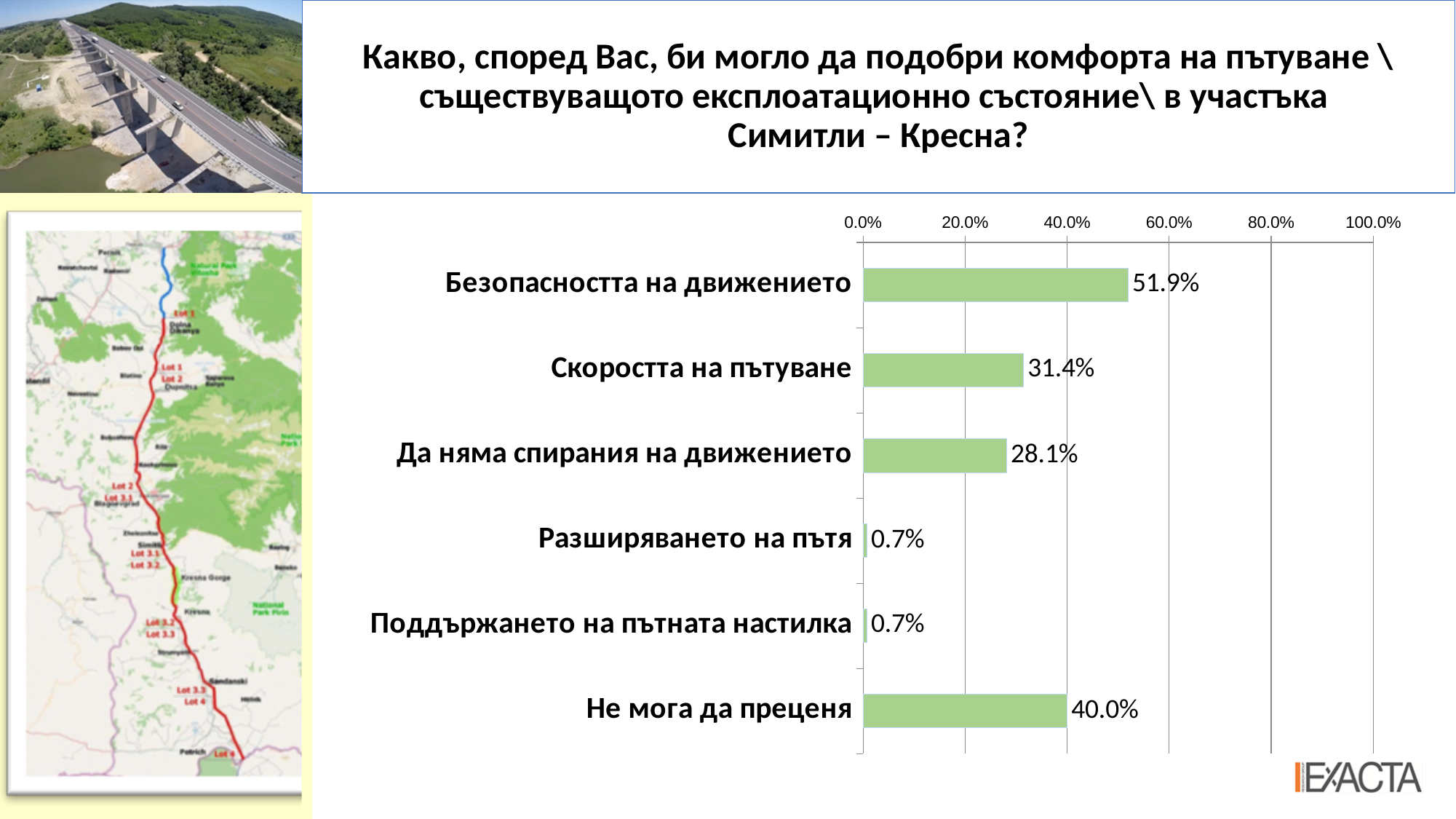
How many categories are shown in the chart? 6 What value is shown for "Не мога да преценя"? 40.0% What percentage is shown for "Безопасността на движението"? 51.9% Which is larger: the value for "Не мога да преценя" or the value for "Скоростта на пътуване"? Не мога да преценя What kind of chart is shown on the slide? bar chart What percentage is shown for "Разширяването на пътя"? 0.7% What value does the bar for "Скоростта на пътуване" show? 31.4% What is the difference between the values for "Безопасността на движението" and "Не мога да преценя"? 11.9% What is the difference between the values for "Скоростта на пътуване" and "Да няма спирания на движението"? 3.3% Which category has the highest value in the chart? Безопасността на движението What percentage is shown for "Да няма спирания на движението"? 28.1% Is the value for "Безопасността на движението" greater or less than 60.0%? less